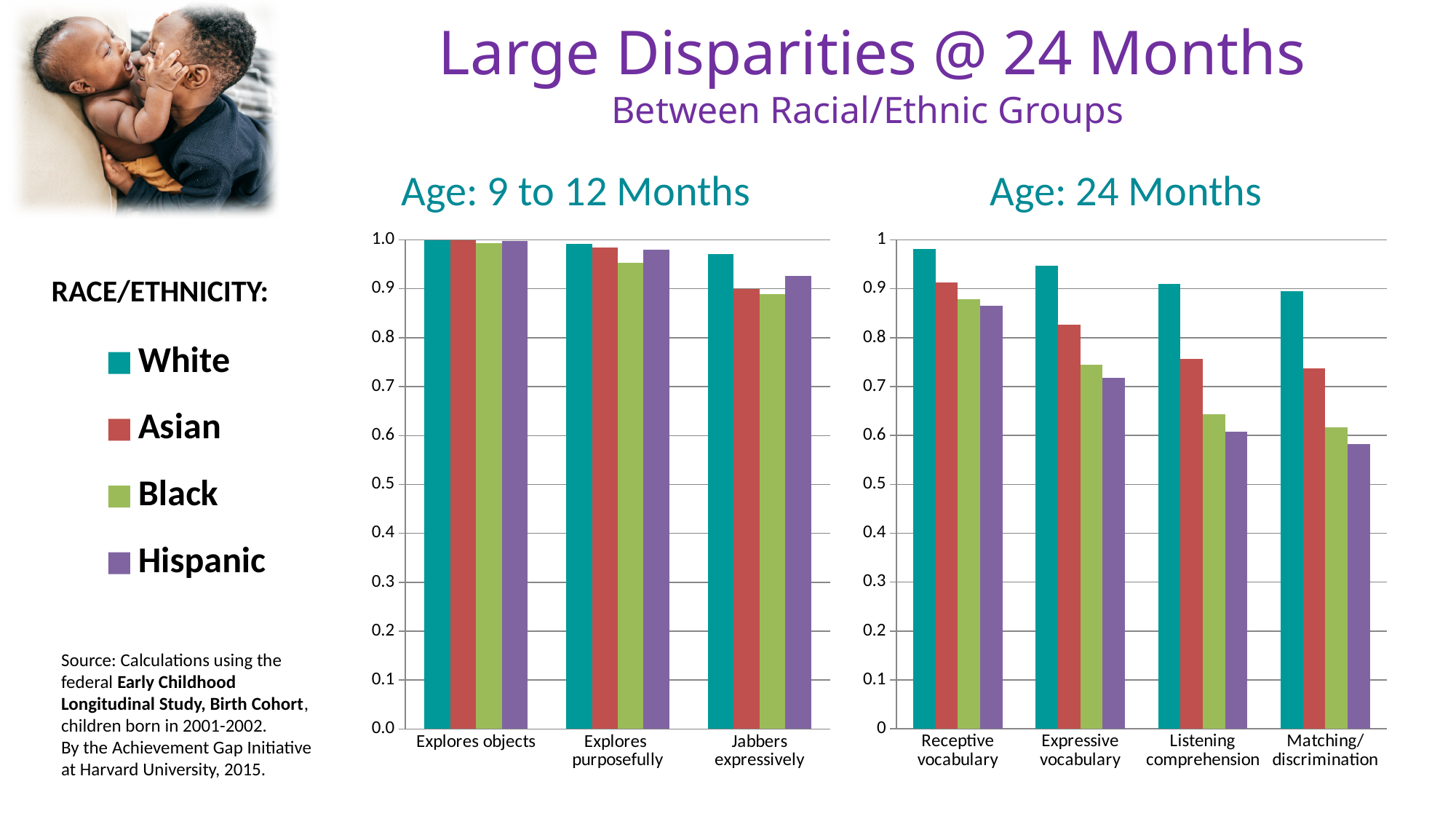
In the "Age: 24 Months" chart, is the value for Hispanic in Matching/discrimination greater or less than 0.6? less In the "Age: 9 to 12 Months" chart, which group has the lowest value for Explores purposefully? Black In the "Age: 24 Months" chart, is the value for White in Receptive vocabulary greater or less than 0.9? greater What kind of chart is the "Age: 24 Months" chart? bar chart In the "Age: 24 Months" chart, which group has the lowest value for Matching/discrimination? Hispanic How many categories are shown on the x axis of the "Age: 9 to 12 Months" chart? 3 Which colour represents Hispanic in the charts? purple In the "Age: 24 Months" chart, which is larger for Listening comprehension, the Asian value or the Black value? Asian How many racial/ethnic groups does the legend list for the charts? 4 In the "Age: 24 Months" chart, do the White values rise or fall from Receptive vocabulary to Matching/discrimination? fall How many categories are shown on the x axis of the "Age: 24 Months" chart? 4 In the "Age: 24 Months" chart, which group has the highest value for Receptive vocabulary? White